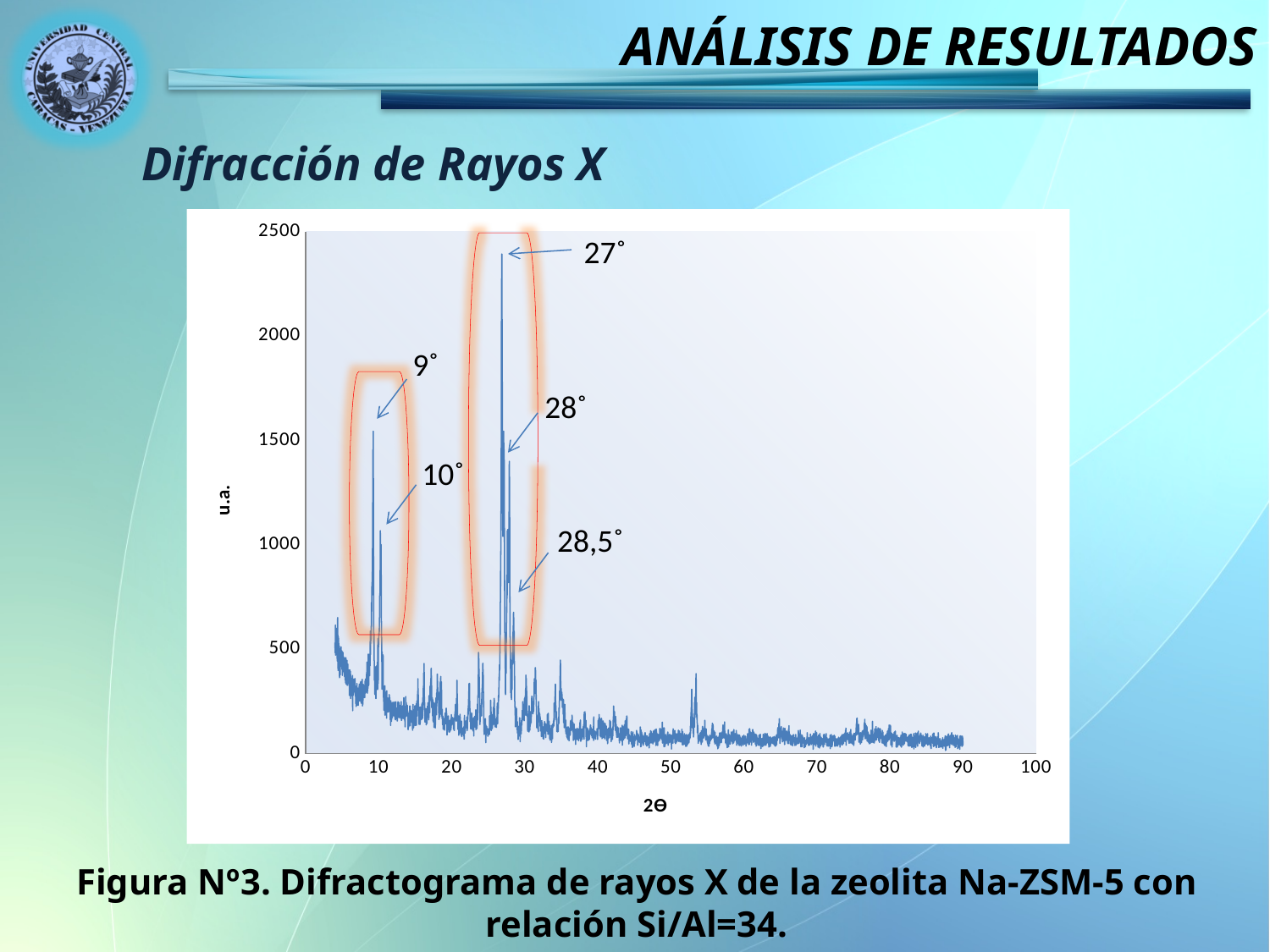
How many peak angles are annotated with labels on the chart? 5 Which peak has a higher intensity, the one at 27˚ or the one at 9˚? 27˚ Which peak has a higher intensity, the one at 9˚ or the one at 10˚? 9˚ Is the intensity of the peak at 27˚ greater or less than 2000? greater Which peak has a higher intensity, the one at 28˚ or the one at 28,5˚? 28˚ Overall, does the intensity rise or fall as 2Θ increases from 30 to 90? fall What is the label of the vertical axis of the chart? u.a. What kind of chart is shown on the slide? line chart Is the intensity of the peak at 10˚ greater or less than 1500? less Is the intensity of the peak at 9˚ greater or less than 1000? greater Which annotated peak angle has the highest intensity in the diffractogram? 27˚